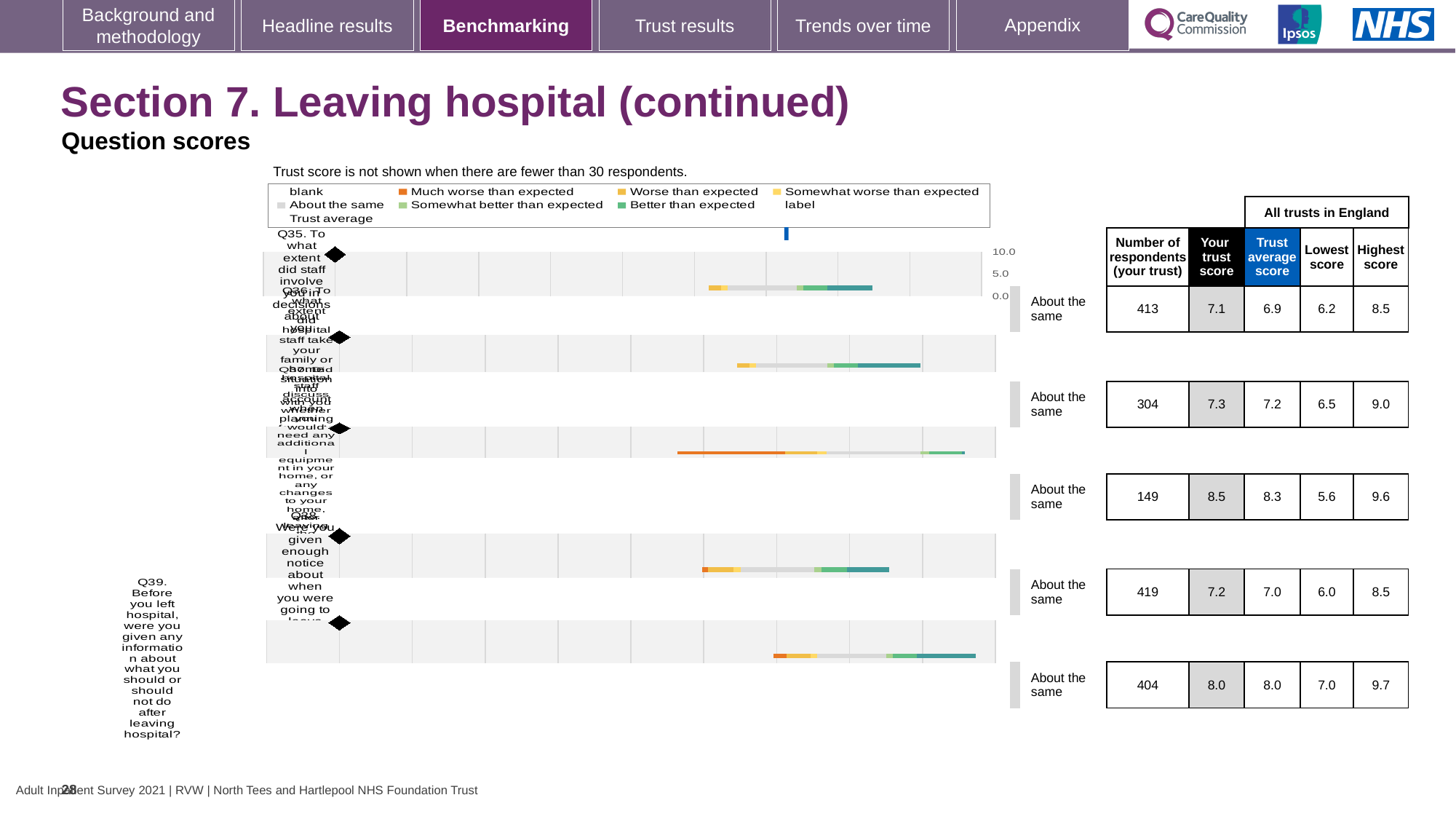
What is the maximum value shown on the chart's score axis? 10.0 Which legend entry is shown in dark orange in the benchmarking chart? Much worse than expected How many respondents answered Q39 at this trust? 404 What is the highest score across all trusts in England for Q39? 9.7 What is the trust score for Q38 (given enough notice about when you were going to leave)? 7.2 Which benchmarking category is shown for Q39 (information about what you should or should not do after leaving hospital)? About the same What is the difference between the highest and lowest score in England for Q38 (given enough notice about when you were going to leave)? 2.5 How many questions (rows) are plotted in the benchmarking chart? 5 Is the trust score for Q38 (given enough notice about when you were going to leave) greater or less than the trust average score? greater What kind of chart is used to show the question scores on this slide? bar chart What is the trust score for Q39 (information about what you should or should not do after leaving hospital)? 8.0 What is the trust average score for Q39 (information about what you should or should not do after leaving hospital)? 8.0